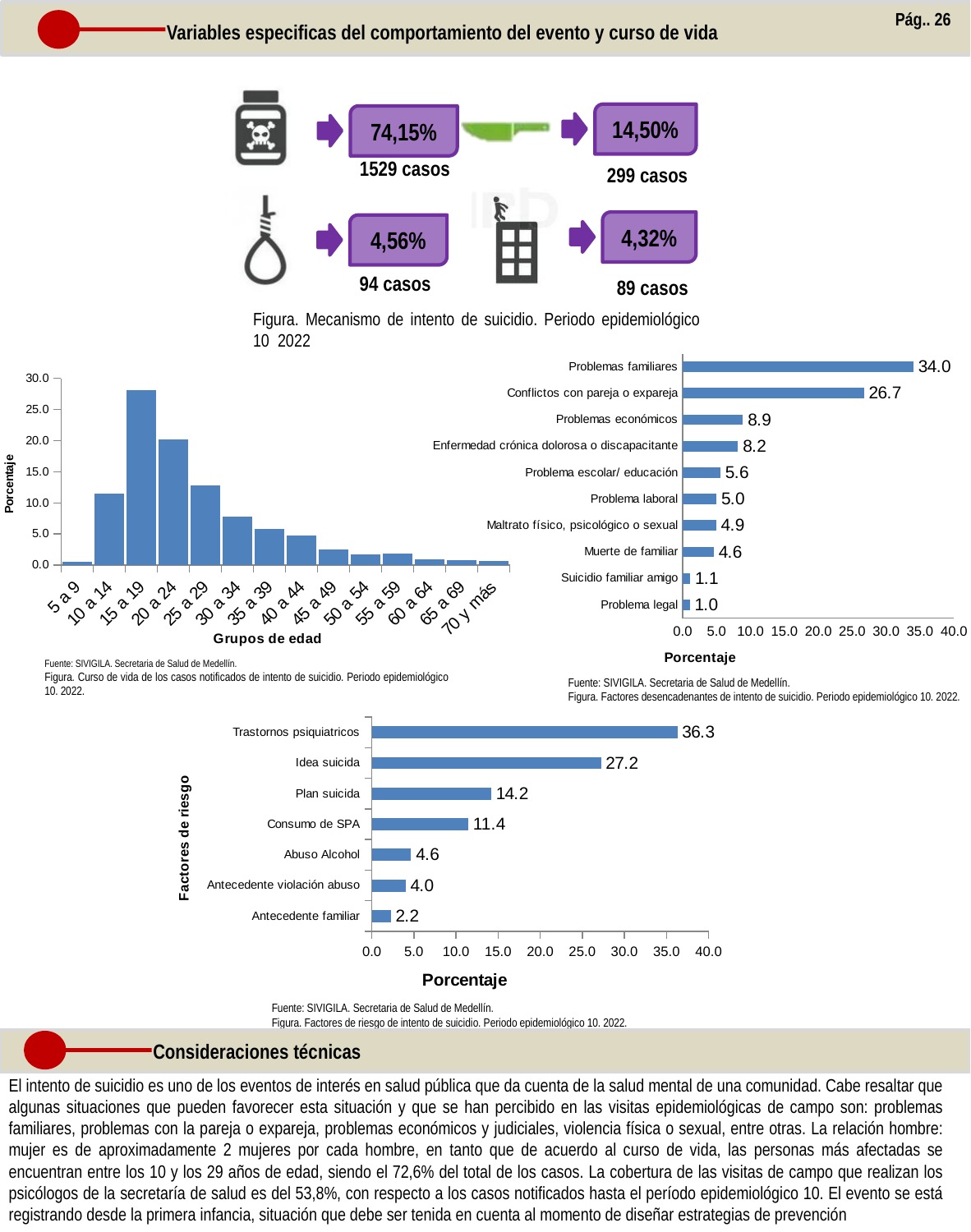
In the 'Factores desencadenantes' chart (right), what is the value for Enfermedad crónica dolorosa o discapacitante? 8.2 In the 'Factores de riesgo' chart (bottom), which is larger, Abuso Alcohol or Antecedente violación abuso? Abuso Alcohol In the 'Factores de riesgo' chart (bottom), what is the difference between Trastornos psiquiatricos and Idea suicida? 9.1 In the 'Factores desencadenantes' chart (right), what is the value for Problemas familiares? 34.0 In the 'Factores desencadenantes' chart (right), what is the difference between Problemas familiares and Conflictos con pareja o expareja? 7.3 In the 'Grupos de edad' chart (left), how many age groups are shown on the x axis? 14 In the 'Factores desencadenantes' chart (right), which category has the lowest value? Problema legal In the 'Factores de riesgo' chart (bottom), what is the value for Consumo de SPA? 11.4 In the 'Grupos de edad' chart (left), which age group has the highest percentage? 15 a 19 In the 'Factores desencadenantes' chart (right), how many categories are plotted? 10 In the 'Grupos de edad' chart (left), is the value for 15 a 19 greater or less than 25.0? greater In the 'Factores de riesgo' chart (bottom), which category has the highest value? Trastornos psiquiatricos